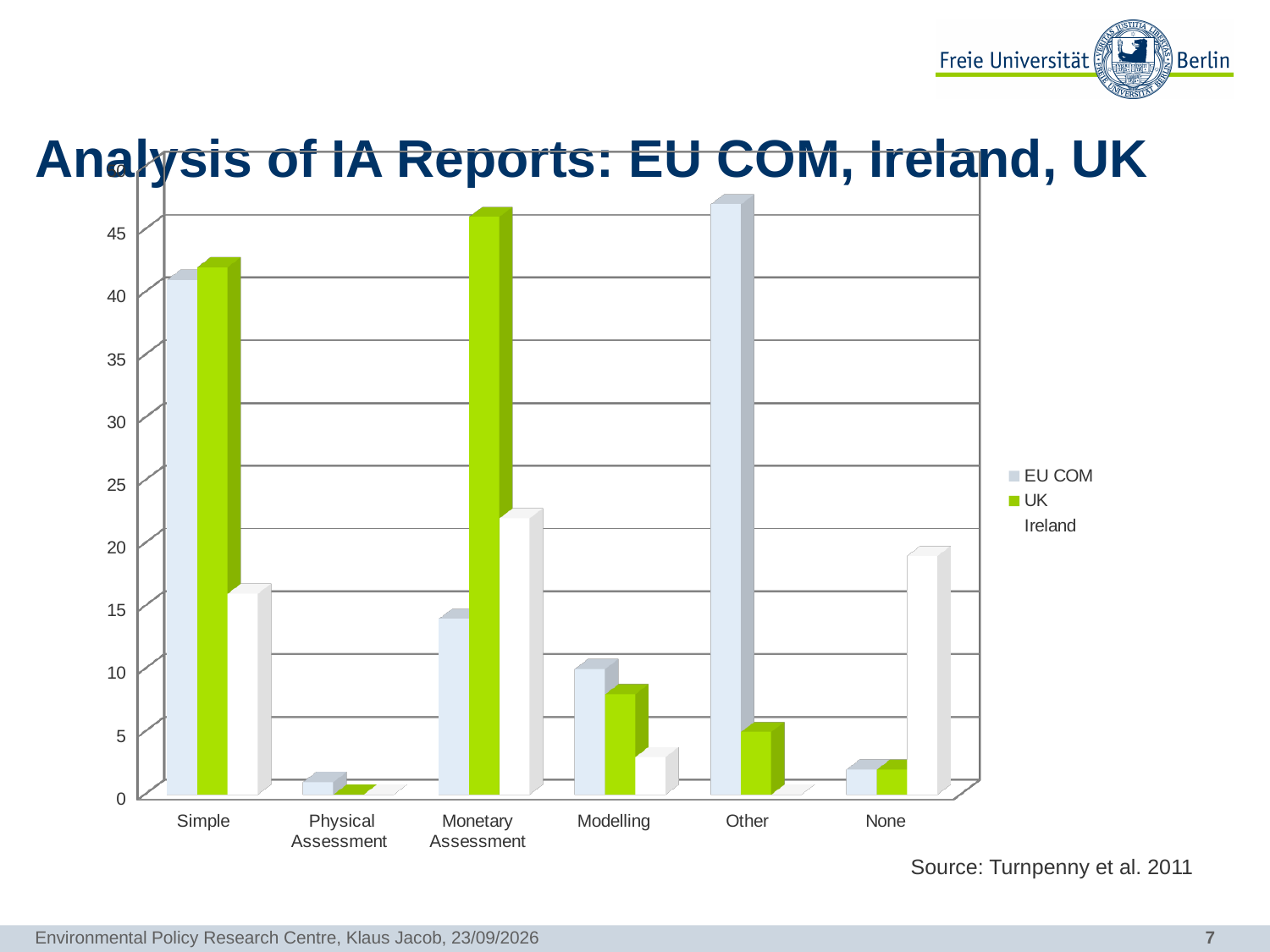
Which series is shown in green in the legend? UK For Monetary Assessment, which series has the larger value, EU COM or Ireland? Ireland Which category has the highest UK value? Monetary Assessment Is the Ireland value for None greater or less than 15? greater Which category has the highest Ireland value? Monetary Assessment Is the EU COM value for Modelling greater or less than 15? less What kind of chart is shown on the slide? bar chart How many categories are shown on the x axis? 6 For Other, which series has the larger value, EU COM or UK? EU COM How many series does the legend list? 3 Which category has the highest EU COM value? Other Is the UK value for Monetary Assessment greater or less than 40? greater